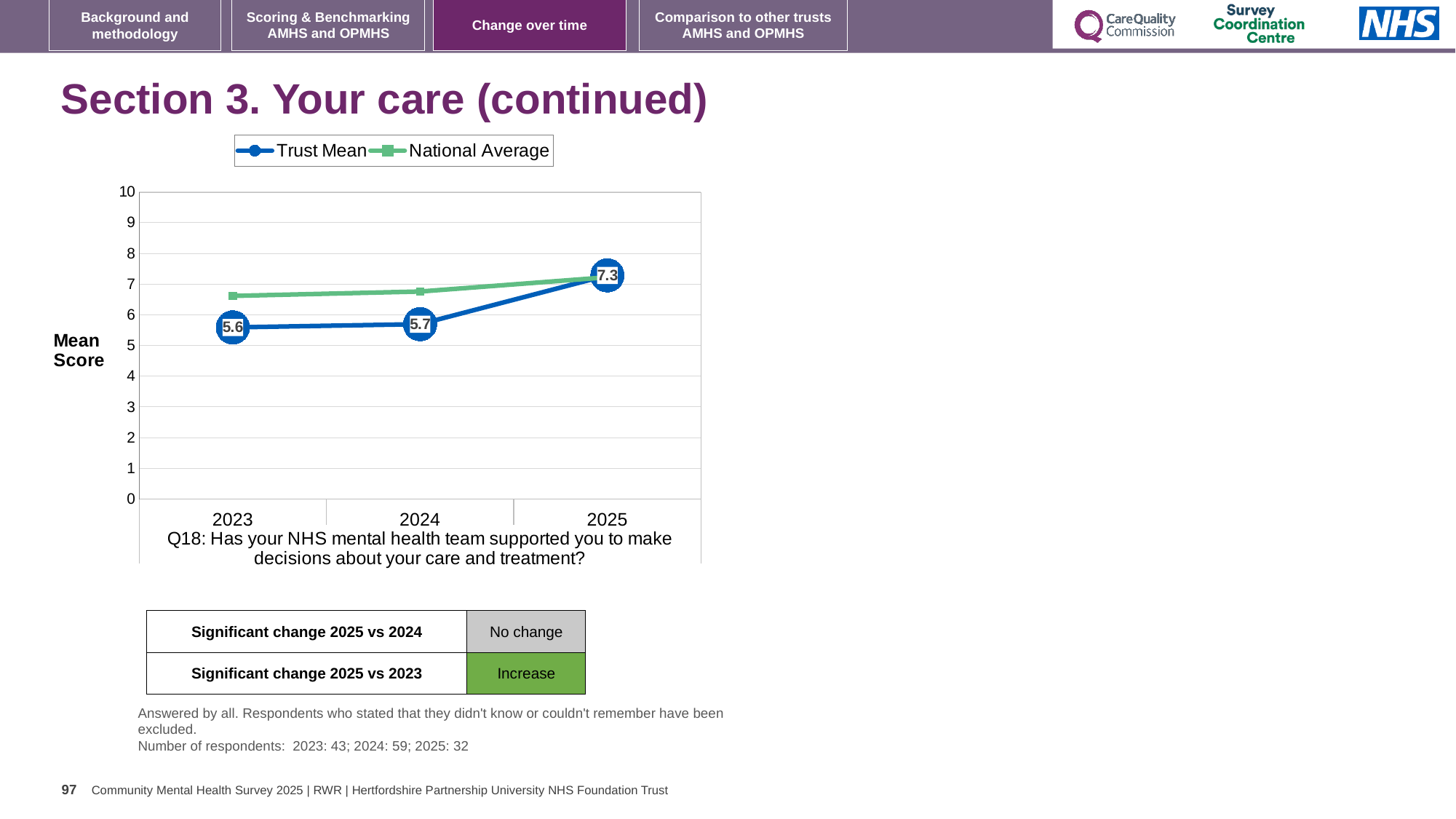
What is the Trust Mean score for 2023? 5.6 Which is larger, the Trust Mean in 2025 or the Trust Mean in 2024? 2025 In which year is the Trust Mean lowest? 2023 How many series does the legend list? 2 What is the Trust Mean score for 2025? 7.3 What is the difference between the Trust Mean in 2025 and in 2023? 1.7 Is the Trust Mean value for 2024 greater or less than 6? less In which year is the Trust Mean highest? 2025 What is the Trust Mean score for 2024? 5.7 Is the National Average value for 2023 greater or less than 6? greater What kind of chart is shown on the slide? Line chart How many years are shown on the x axis? 3